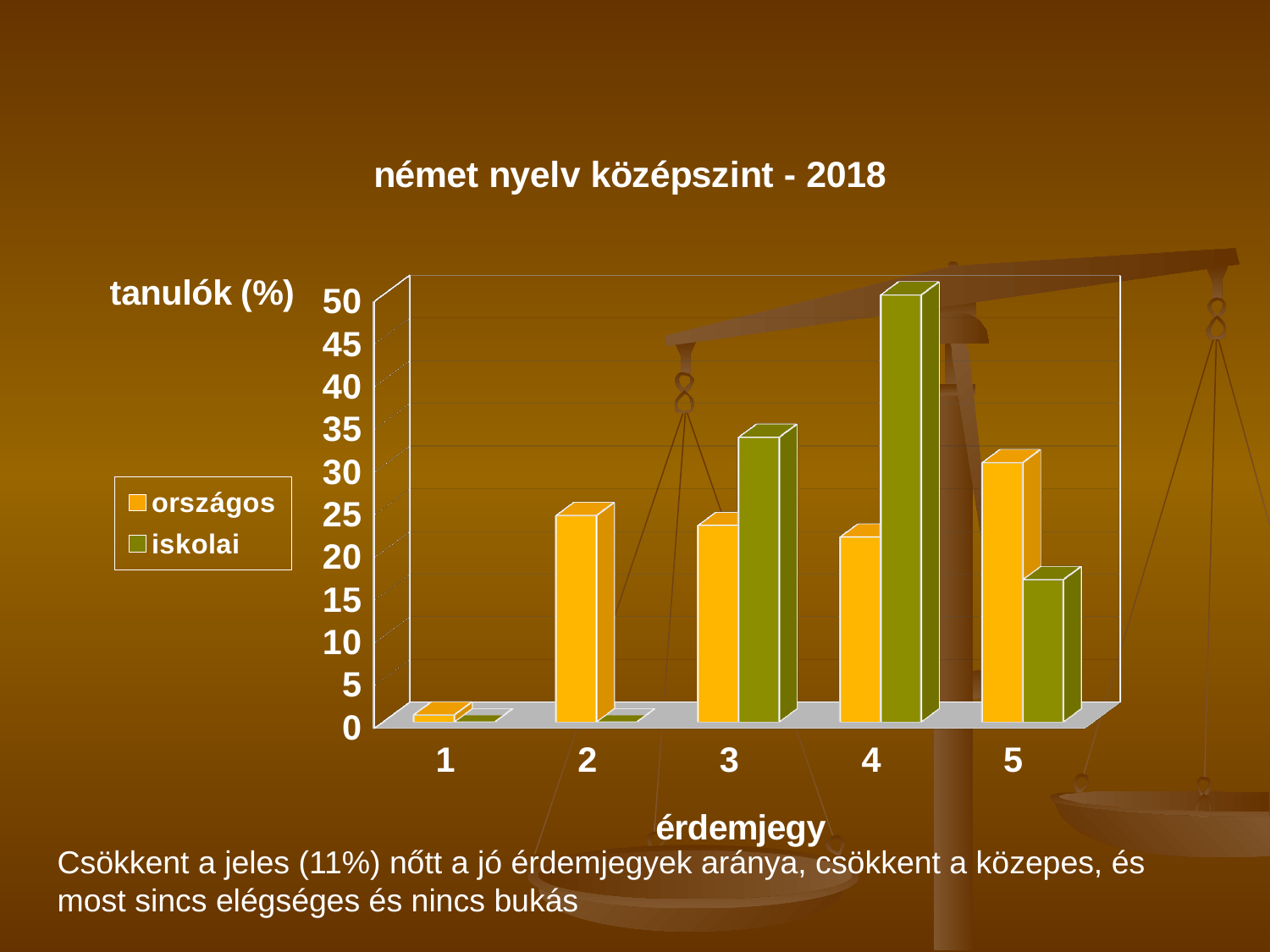
For érdemjegy 5, which series has the larger value, országos or iskolai? országos How many series does the legend list? 2 Which two series are listed in the legend? országos and iskolai Is the iskolai value for érdemjegy 5 greater or less than 20? less For which érdemjegy is the iskolai value highest? 4 Is the iskolai value for érdemjegy 4 greater or less than 40? greater For which érdemjegy is the országos value highest? 5 For érdemjegy 4, which series has the larger value, országos or iskolai? iskolai How many érdemjegy categories are shown on the x axis? 5 For which érdemjegy is the országos value lowest? 1 What kind of chart is shown on the slide? bar chart What is the title of the chart? német nyelv középszint - 2018